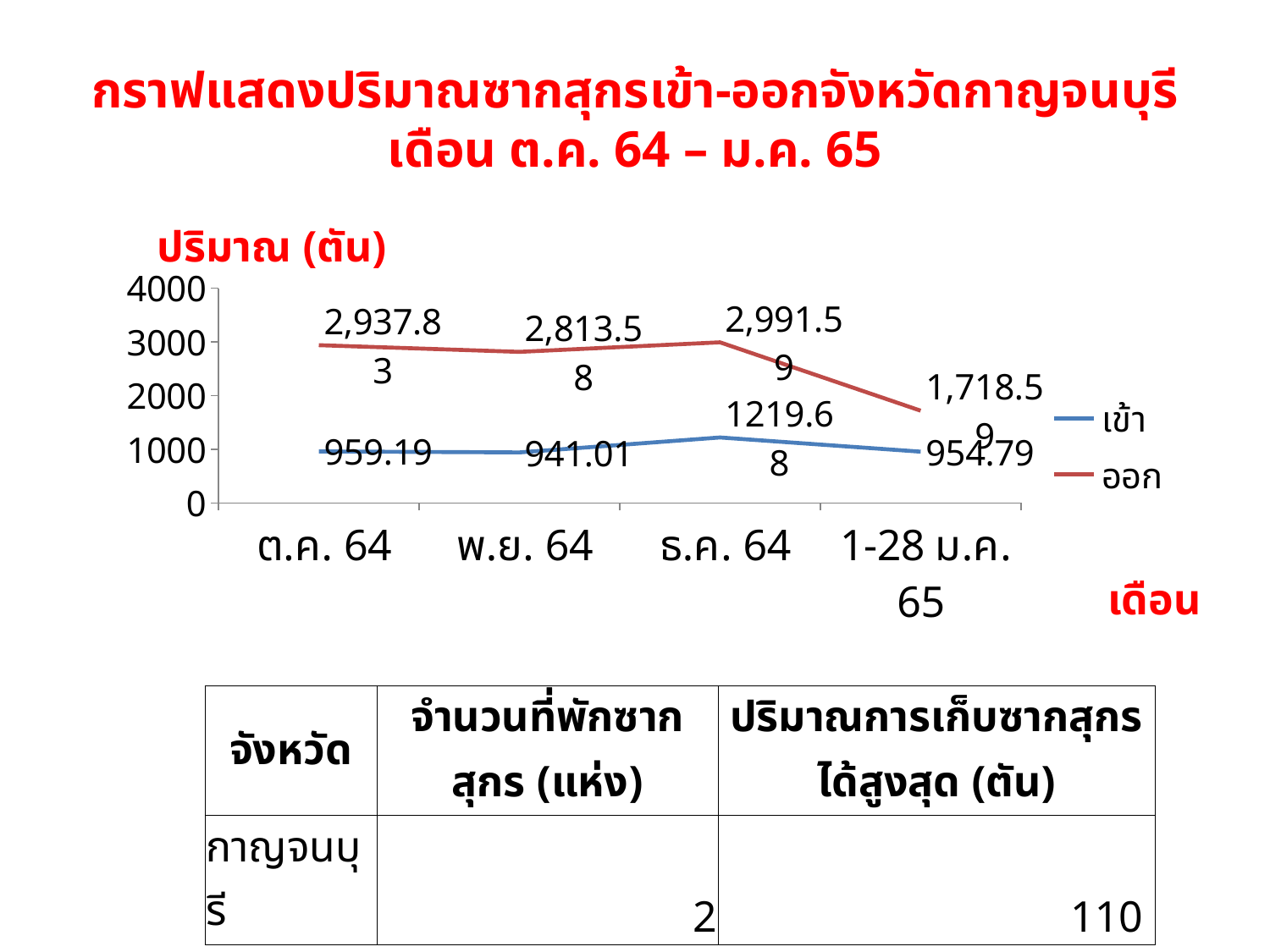
In which month is the ออก series highest? ธ.ค. 64 What kind of chart is shown on the slide? line chart What is the value of the เข้า series for พ.ย. 64? 941.01 What is the value of the เข้า series for ธ.ค. 64? 1219.68 Is the ออก value for 1-28 ม.ค. 65 greater or less than 2000? less How many series does the chart legend list? 2 What is the label on the y axis of the chart? ปริมาณ (ตัน) What is the value of the ออก series for 1-28 ม.ค. 65? 1,718.59 Which is larger for ธ.ค. 64, the เข้า value or the ออก value? ออก How many months (categories) are plotted along the x axis of the chart? 4 In which month is the เข้า series lowest? พ.ย. 64 What is the value of the ออก series for ต.ค. 64? 2,937.83